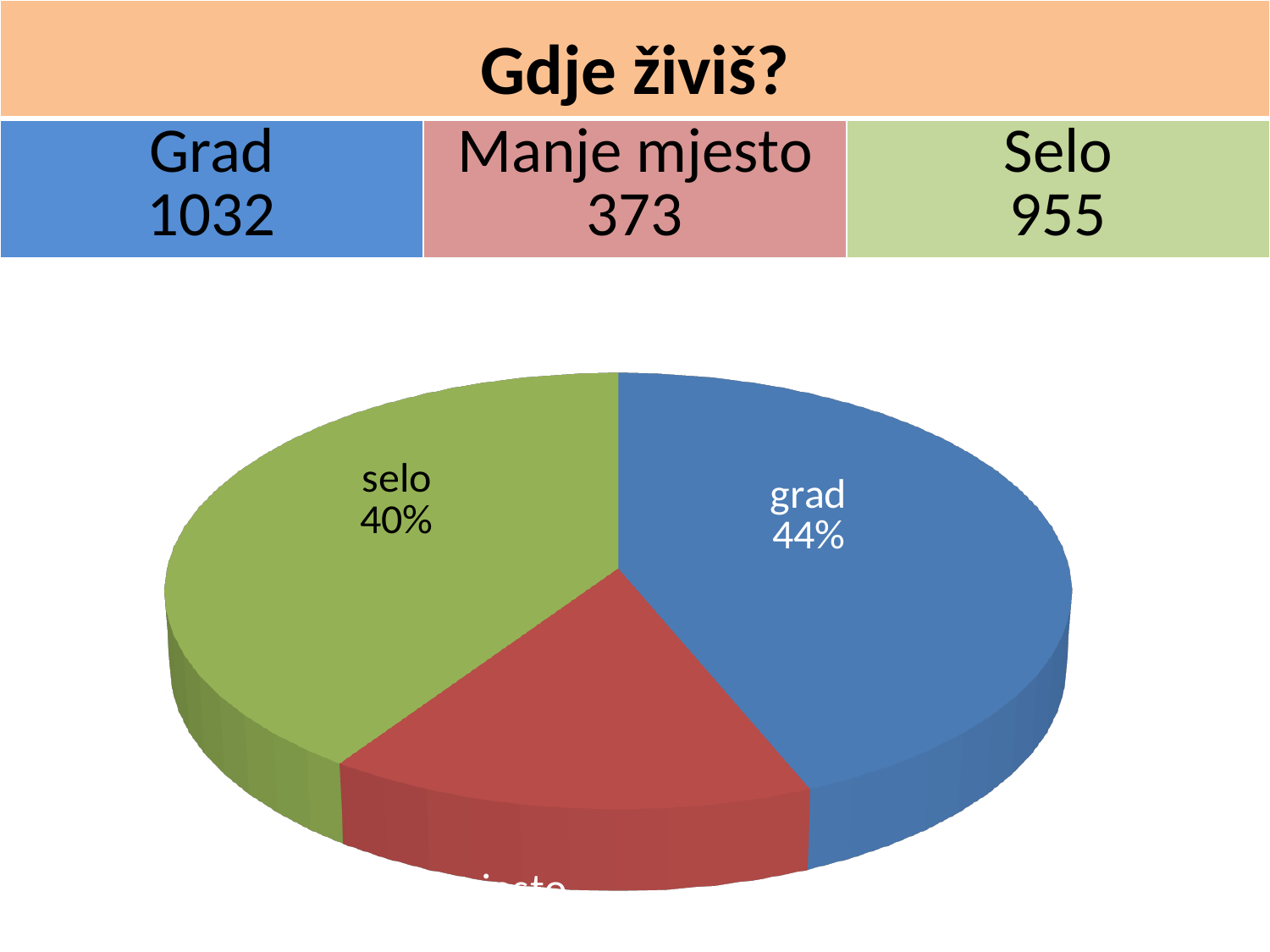
According to the table above the chart, how many respondents answered 'Manje mjesto'? 373 According to the table above the chart, how many respondents answered 'Selo'? 955 What kind of chart is shown on the slide? pie chart How many slices does the pie chart have? 3 What share of the pie does the 'grad' slice represent? 44% What colour is the 'grad' slice in the pie chart? blue Which slice of the pie chart is the largest? grad What share of the pie does the 'selo' slice represent? 40% According to the table above the chart, how many respondents answered 'Grad'? 1032 Which is larger, the 'grad' slice or the 'selo' slice? grad What is the difference in percentage points between the 'grad' slice and the 'selo' slice? 4 percentage points What is the title shown at the top of the slide? Gdje živiš?